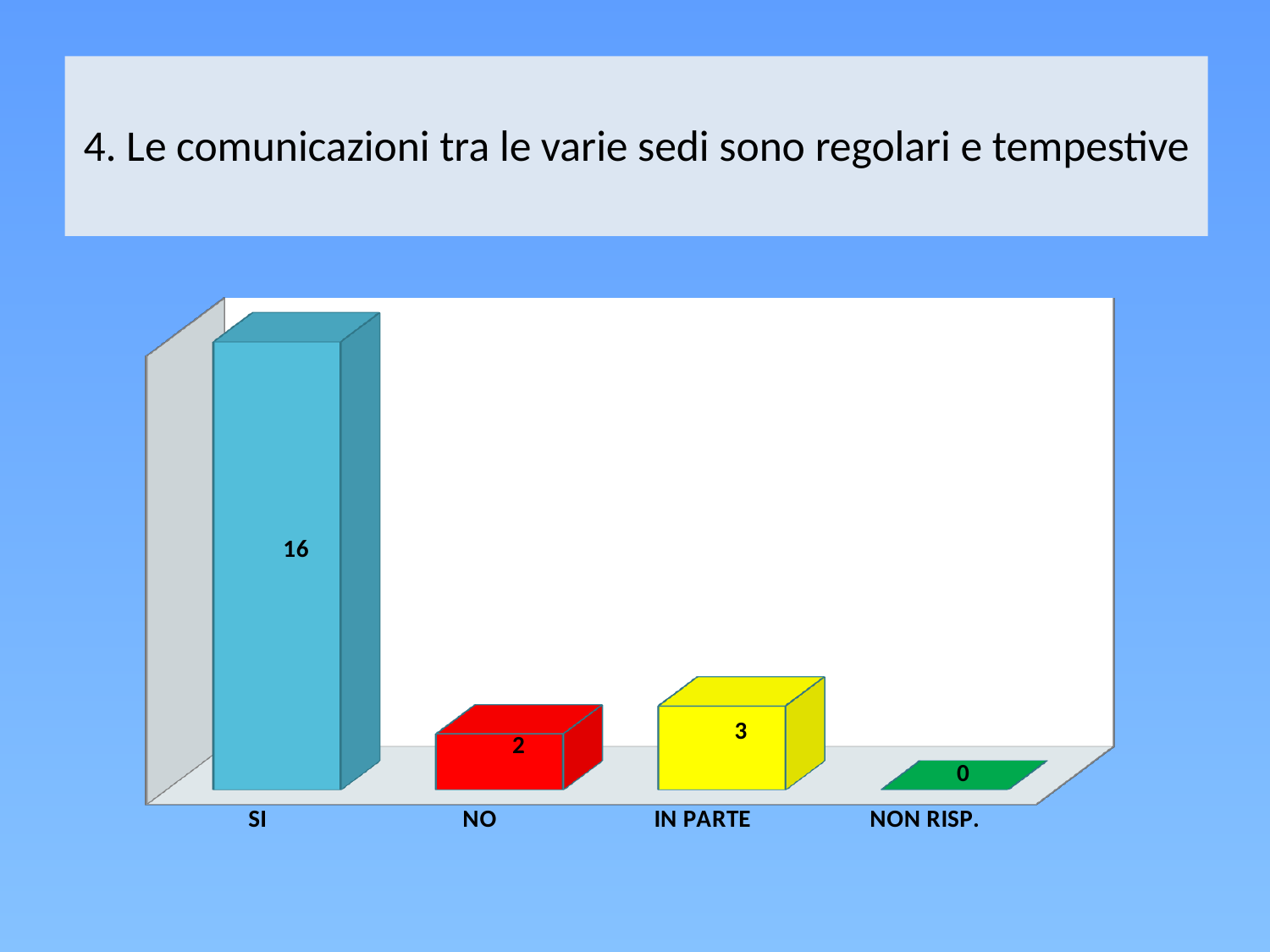
What is the difference between the values for SI and IN PARTE? 13 Which category has the lowest value? NON RISP. How many categories are shown on the x axis? 4 Which category has the highest value? SI What is the value for IN PARTE? 3 Which is larger, the value for NO or the value for IN PARTE? IN PARTE What is the value for NON RISP.? 0 What is the difference between the values for IN PARTE and NO? 1 What kind of chart is shown on the slide? bar chart What is the value for NO? 2 What is the value for SI? 16 What colour is the bar for IN PARTE? yellow